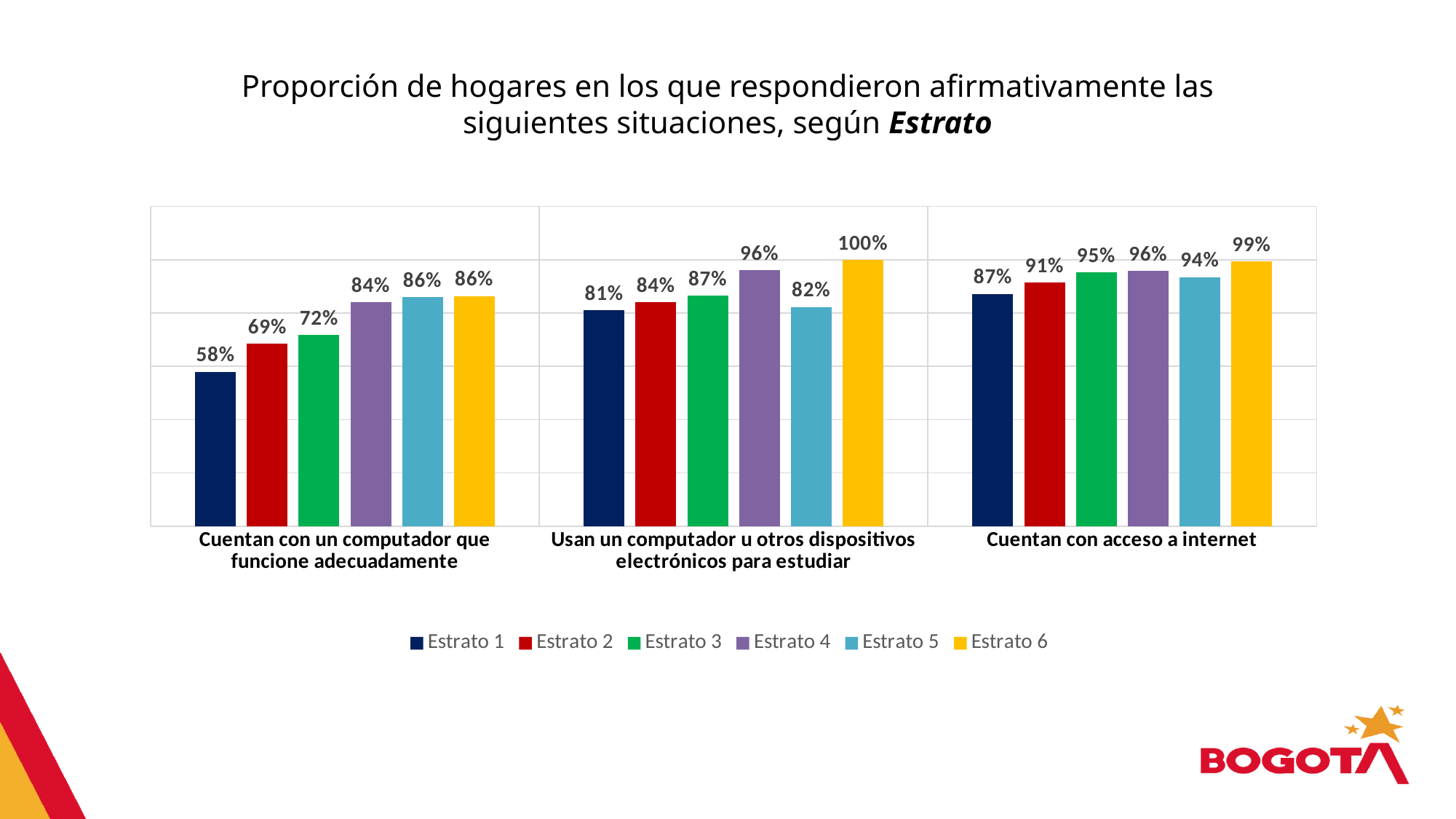
In the category "Usan un computador u otros dispositivos electrónicos para estudiar", which is larger: Estrato 4 or Estrato 5? Estrato 4 How many categories are shown on the x axis? 3 What kind of chart is shown on the slide? Bar chart Which Estrato has the lowest value in the category "Cuentan con un computador que funcione adecuadamente"? Estrato 1 What colour represents Estrato 6 in the legend? Yellow Which Estrato has the highest value in the category "Cuentan con acceso a internet"? Estrato 6 What is the value for Estrato 6 in the category "Usan un computador u otros dispositivos electrónicos para estudiar"? 100% What is the value for Estrato 1 in the category "Cuentan con un computador que funcione adecuadamente"? 58% How many series does the legend list? 6 What is the difference between Estrato 2 and Estrato 1 in the category "Cuentan con acceso a internet"? 4% What is the difference between Estrato 6 and Estrato 1 in the category "Cuentan con un computador que funcione adecuadamente"? 28% What is the value for Estrato 5 in the category "Cuentan con acceso a internet"? 94%